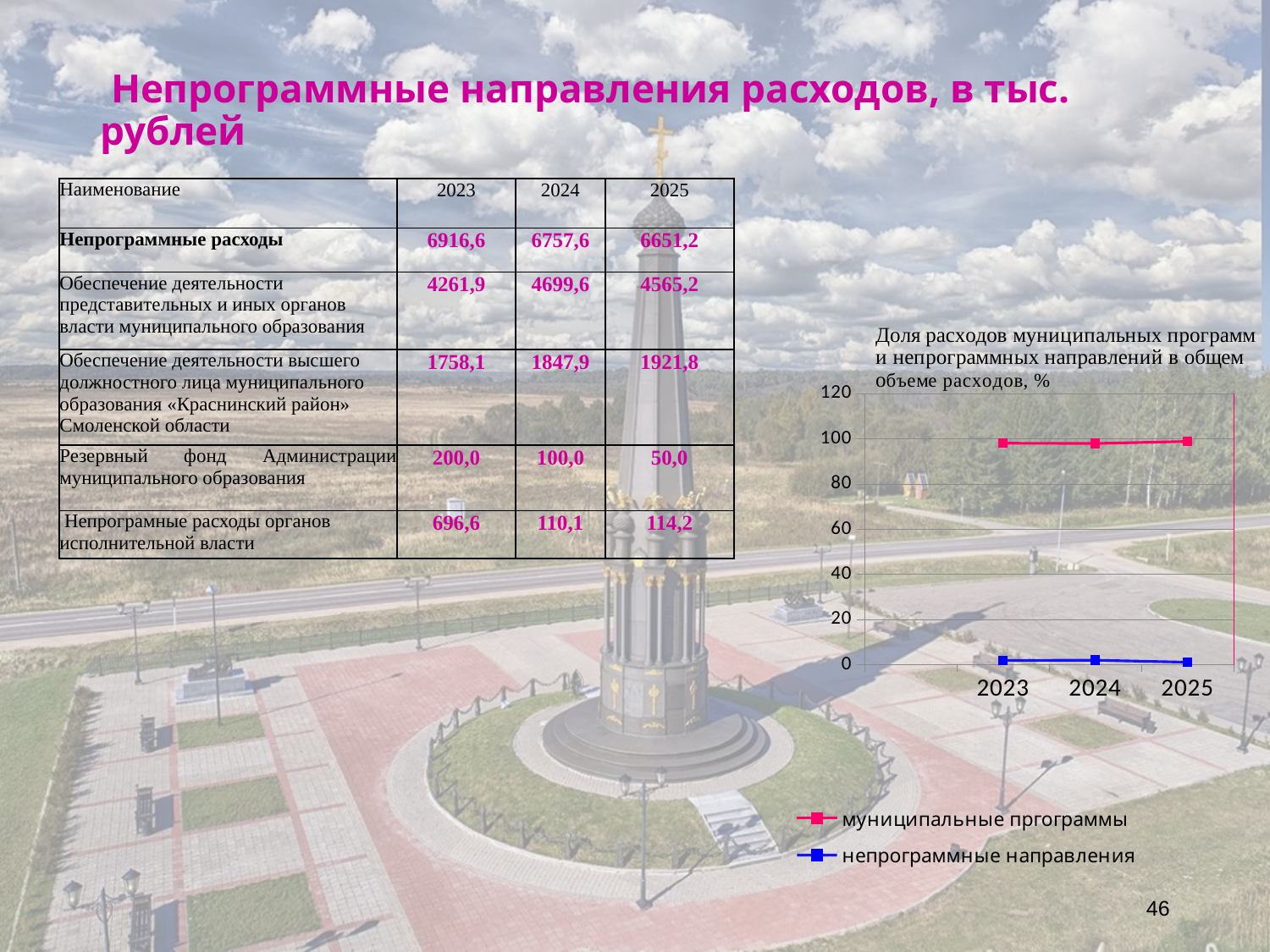
In 2023, which series has the smaller value: муниципальные программы or непрограммные направления? непрограммные направления What is the title of the chart? Доля расходов муниципальных программ и непрограммных направлений в общем объеме расходов, % Which years are shown on the x axis of the chart? 2023, 2024, 2025 How many series does the legend of the chart list? 2 Is the value for муниципальные программы in 2023 greater or less than 80? greater What kind of chart is shown on the right side of the slide? line chart In 2024, which series has the larger value: муниципальные программы or непрограммные направления? муниципальные программы How many years are shown on the x axis of the chart? 3 Is the value for непрограммные направления in 2024 greater or less than 20? less Is the value for муниципальные программы in 2025 greater or less than 60? greater What is the highest value shown on the y axis of the chart? 120